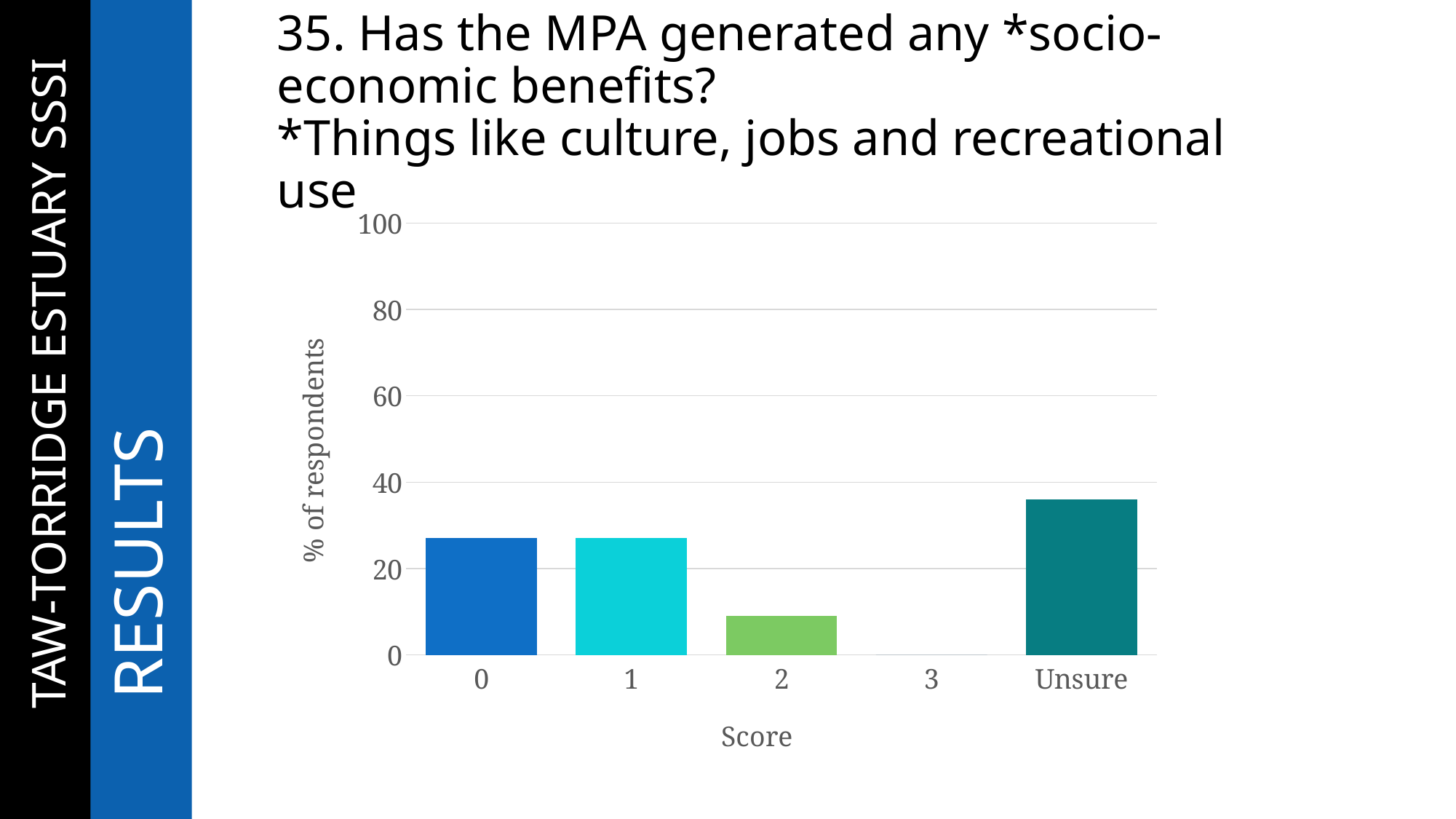
Which is larger, the value for Unsure or the value for score 2? Unsure What is the label on the x axis of the chart? Score Is the value for score 2 greater or less than 20? less Is the value for Unsure greater or less than 40? less Which score category has the highest percentage of respondents? Unsure How many score categories are shown on the x axis of the chart? 5 Is the value for Unsure greater or less than 20? greater Which score category has the lowest percentage of respondents? 3 What is the label on the y axis of the chart? % of respondents What kind of chart is shown on the slide? bar chart